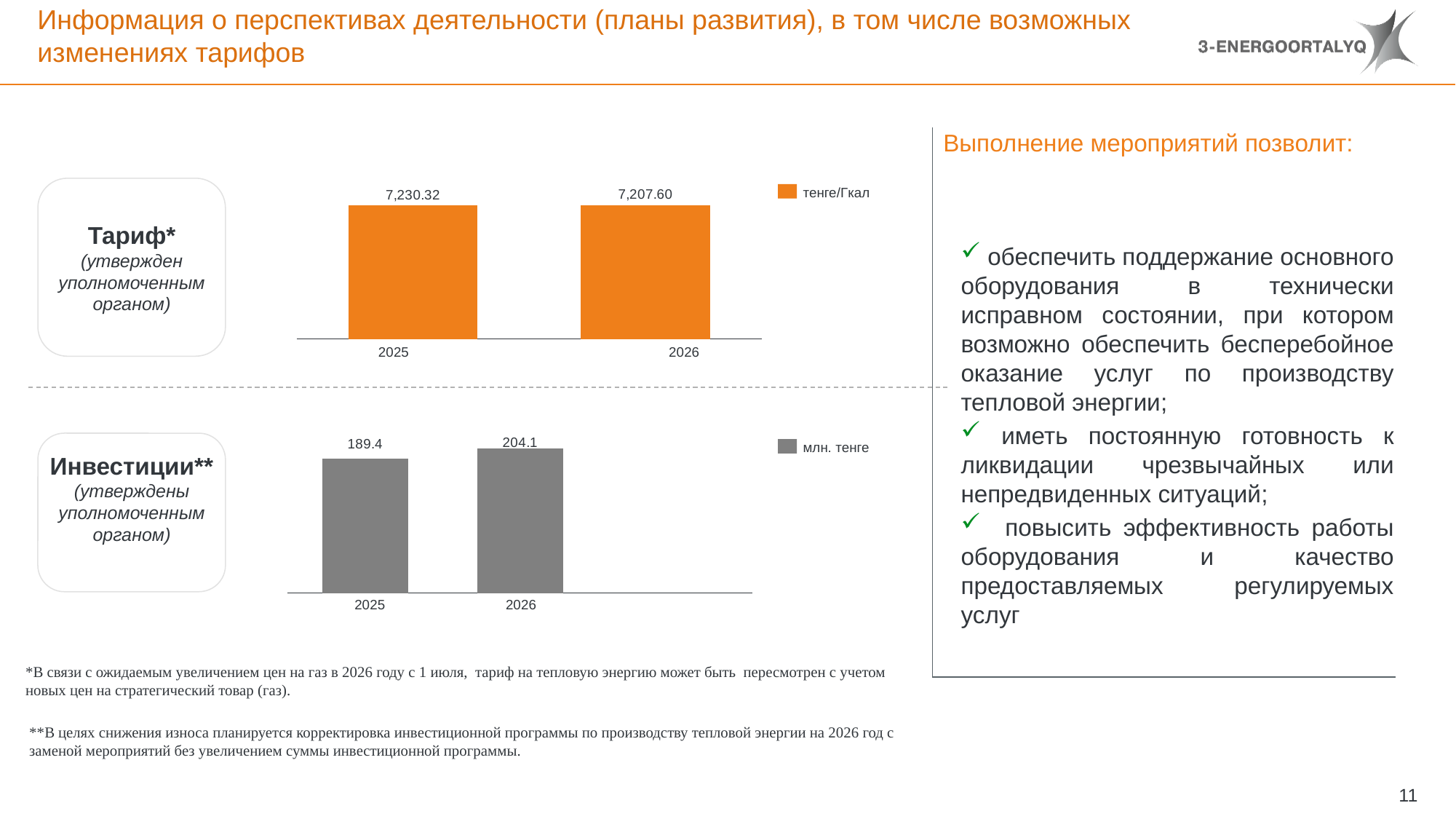
In the top chart (Тариф), what is the difference between the 2025 and 2026 values? 22.72 In the bottom chart (Инвестиции), what is the difference between the 2026 and 2025 values? 14.7 In the bottom chart (Инвестиции), what is the value for 2025? 189.4 In the bottom chart (Инвестиции), what is the value for 2026? 204.1 In the top chart (Тариф), what is the value for 2025? 7,230.32 In the bottom chart (Инвестиции), which year has the lower value? 2025 In the bottom chart (Инвестиции), do the values rise or fall from 2025 to 2026? rise What type of chart is the bottom chart (Инвестиции)? bar chart What unit does the legend of the top chart (Тариф) show? тенге/Гкал In the top chart (Тариф), which year has the higher value? 2025 In the top chart (Тариф), what is the value for 2026? 7,207.60 How many bars are shown in the top chart (Тариф)? 2